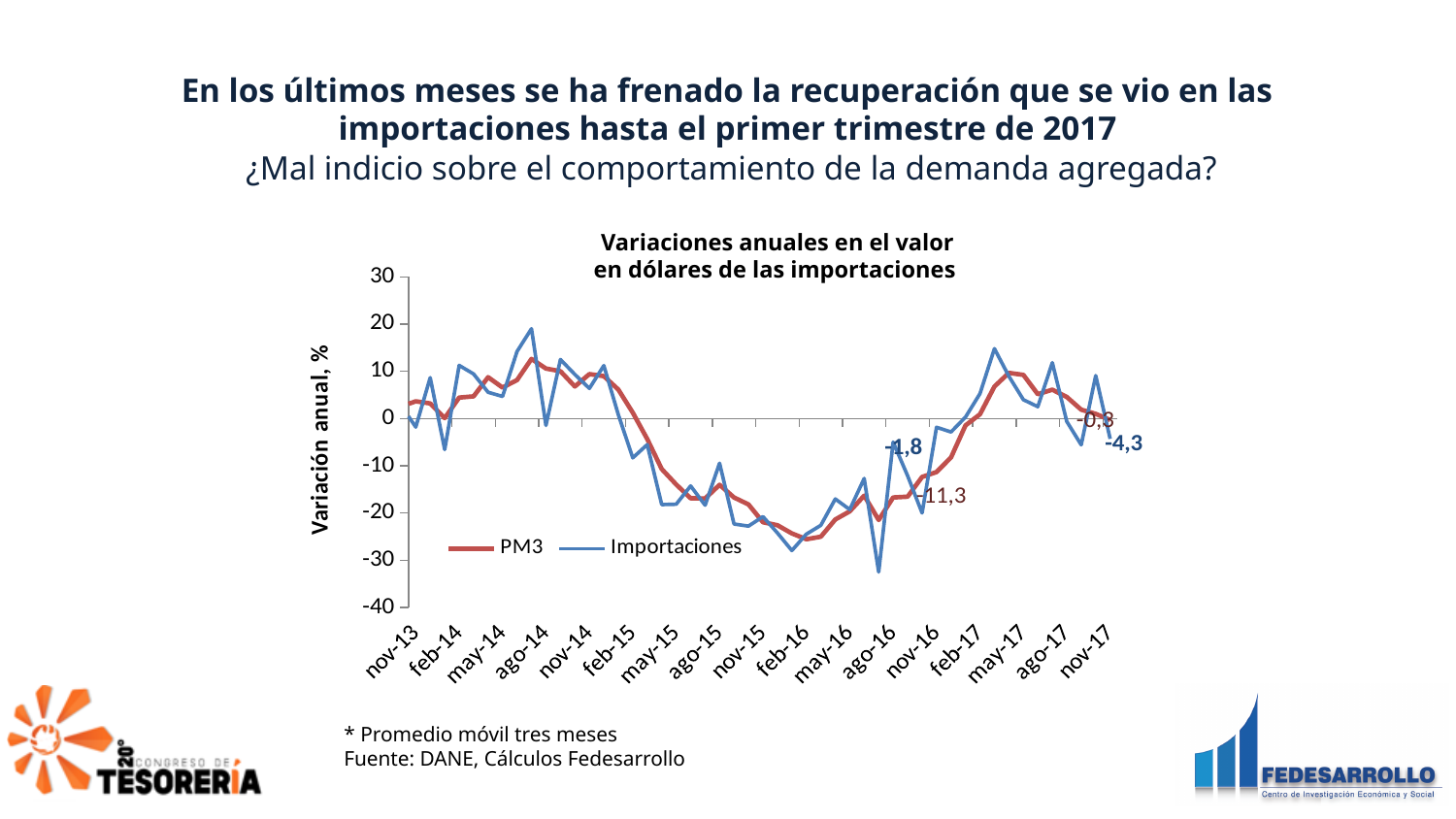
How many series does the chart legend list? 2 What is the labelled value of the PM3 series at nov-17? -0,3 What is the title of the chart? Variaciones anuales en el valor en dólares de las importaciones What is the labelled value of the Importaciones series at nov-16? -1,8 What are the two series named in the chart legend? PM3 and Importaciones What kind of chart is shown on the slide? Line chart What is the difference between the labelled Importaciones value (-1,8) and the labelled PM3 value (-11,3) at nov-16? 9,5 At nov-17, which series has the higher labelled value, PM3 or Importaciones? PM3 What is the labelled value of the PM3 series at nov-16? -11,3 Is the highest value reached by the Importaciones series (around ago-14) greater or less than 10? greater What is the labelled value of the Importaciones series at nov-17? -4,3 Between feb-16 and may-17, does the PM3 series generally rise or fall? rise